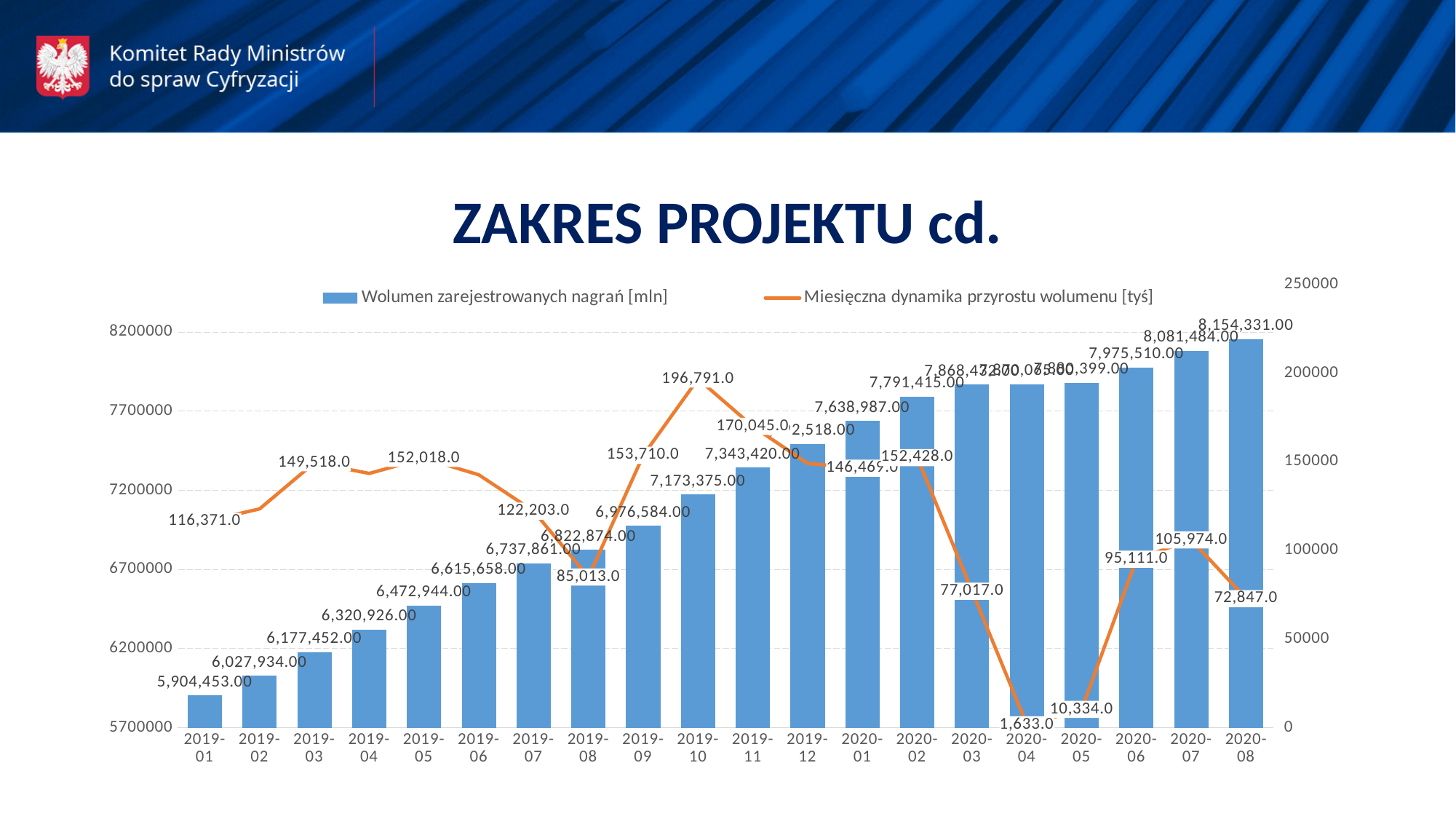
Do the 'Wolumen zarejestrowanych nagrań [mln]' bars rise or fall from 2019-01 to 2020-08? Rise Which month has the highest value of 'Wolumen zarejestrowanych nagrań [mln]'? 2020-08 What is the value of 'Wolumen zarejestrowanych nagrań [mln]' for 2019-01? 5,904,453.00 Which is larger, the 'Wolumen zarejestrowanych nagrań [mln]' value for 2019-10 or for 2019-11? 2019-11 What is the lowest value shown on the 'Miesięczna dynamika przyrostu wolumenu [tyś]' line? 1,633.0 How many series does the chart legend list? 2 Which month has the lowest value of 'Wolumen zarejestrowanych nagrań [mln]'? 2019-01 How many months are shown on the x axis of the chart? 20 What is the difference between the 'Wolumen zarejestrowanych nagrań [mln]' values for 2019-02 and 2019-01? 123,481.00 What is the value of 'Wolumen zarejestrowanych nagrań [mln]' for 2020-08? 8,154,331.00 What kind of chart is shown on the slide? A bar chart combined with a line chart What is the highest value shown on the 'Miesięczna dynamika przyrostu wolumenu [tyś]' line? 196,791.0